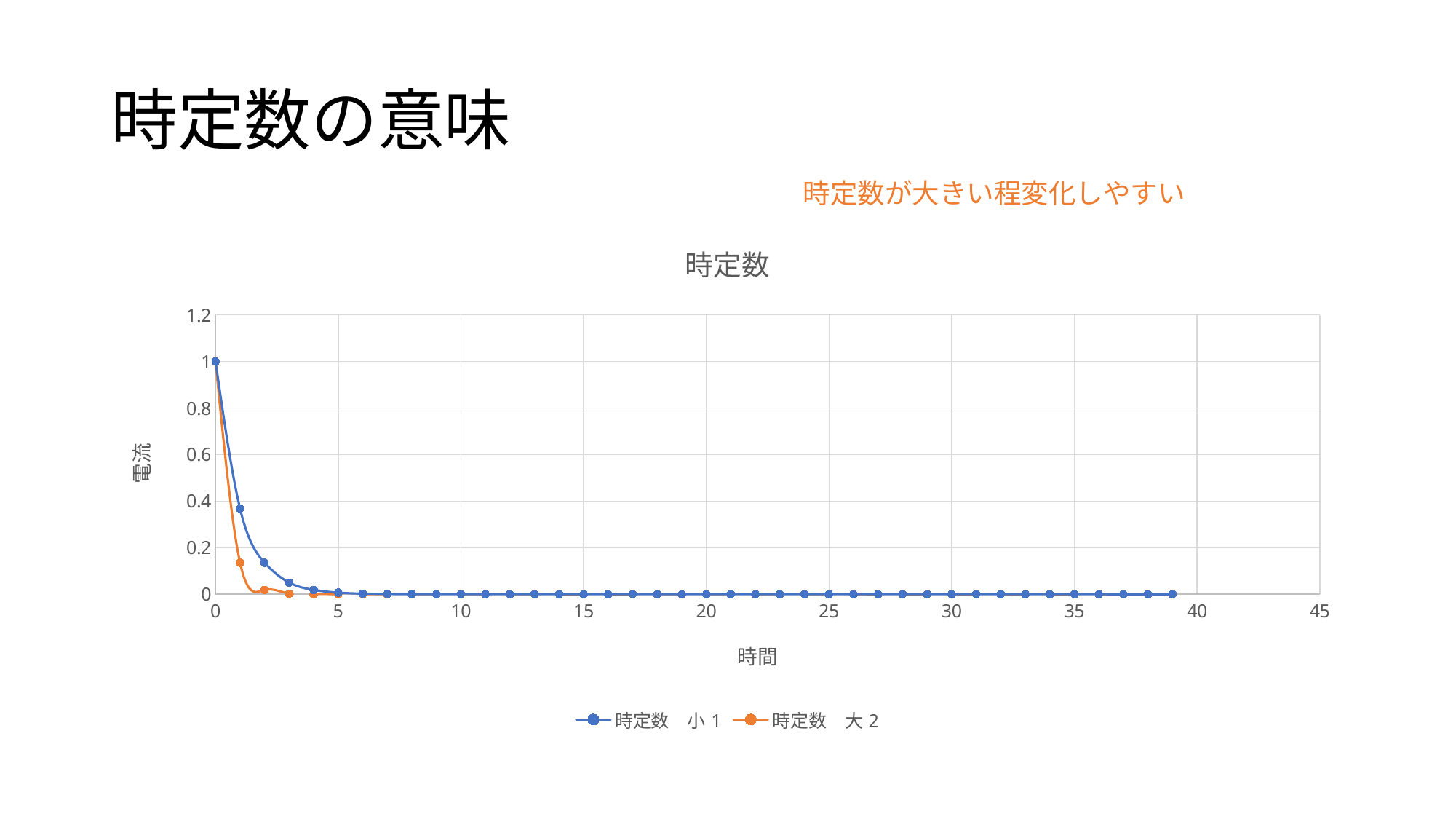
Do the values of the 時定数 大 2 series rise or fall as time increases? fall At time 1, which series has the larger value, 時定数 小 1 or 時定数 大 2? 時定数 小 1 How many series does the legend list? 2 Is the value of the 時定数 小 1 series at time 2 greater or less than 0.2? less Is the value of the 時定数 大 2 series at time 1 greater or less than 0.2? less What is the value of the 時定数 小 1 series at time 0? 1 Do the values of the 時定数 小 1 series rise or fall as time increases? fall What is the title of the chart? 時定数 What kind of chart is shown on the slide? line chart Is the value of the 時定数 小 1 series at time 1 greater or less than 0.2? greater What is the label of the vertical axis? 電流 Which series decays to zero faster, 時定数 小 1 or 時定数 大 2? 時定数 大 2